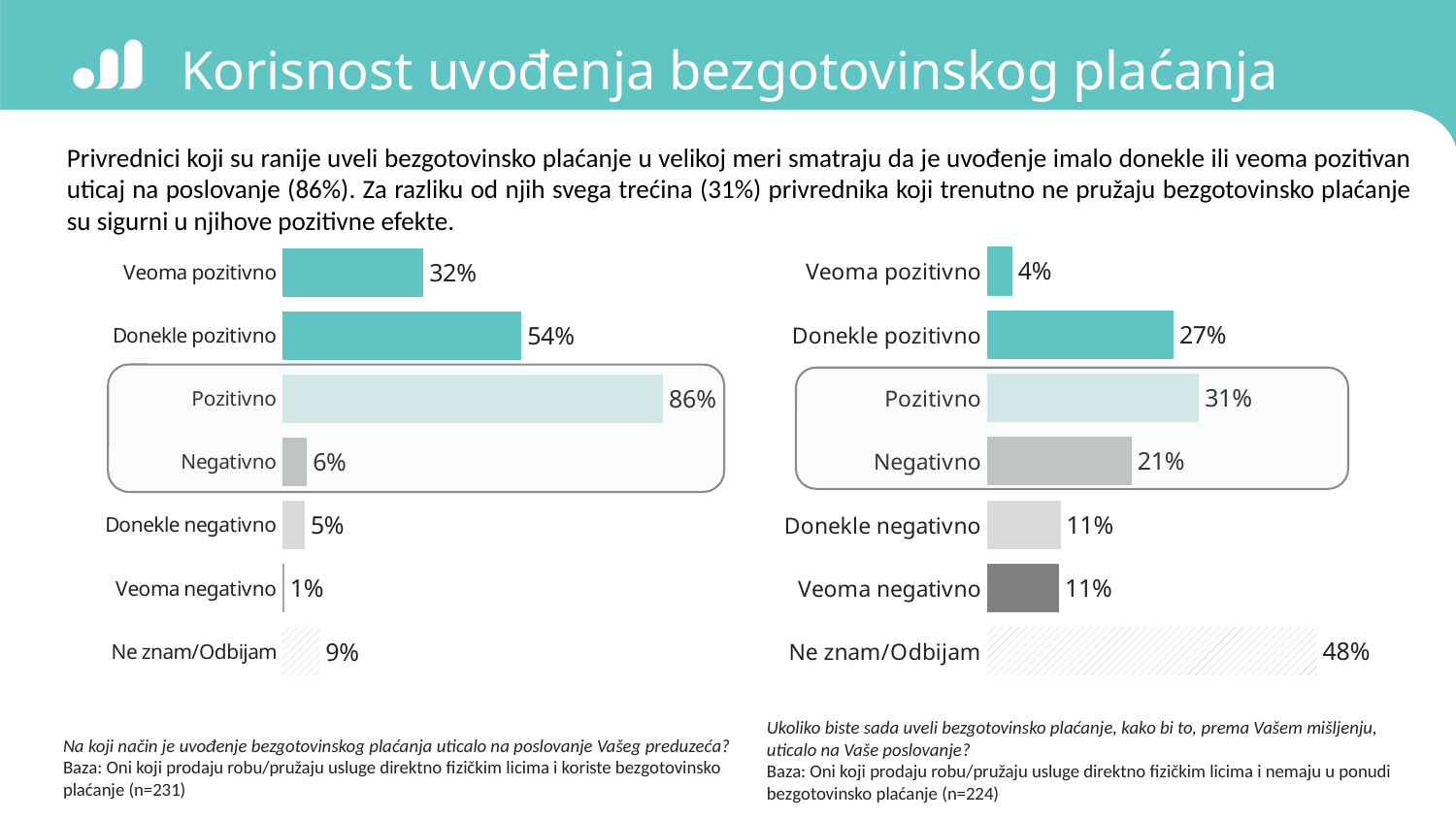
In the right chart, what is the value for Negativno? 21% In the right chart, what is the value for Veoma pozitivno? 4% In the right chart, which is larger: Donekle pozitivno or Negativno? Donekle pozitivno In the left chart, what is the value for Donekle pozitivno? 54% In the left chart, what is the difference between Donekle pozitivno and Veoma pozitivno? 22% In the left chart, which category has the highest value? Pozitivno In the right chart, which category has the lowest value? Veoma pozitivno What is the difference between the Pozitivno values in the left chart and the right chart? 55% In the left chart, what is the value for Veoma negativno? 1% What type of chart is the right chart? Bar chart How many categories are shown in the left chart? 7 In the right chart, what is the value for Ne znam/Odbijam? 48%